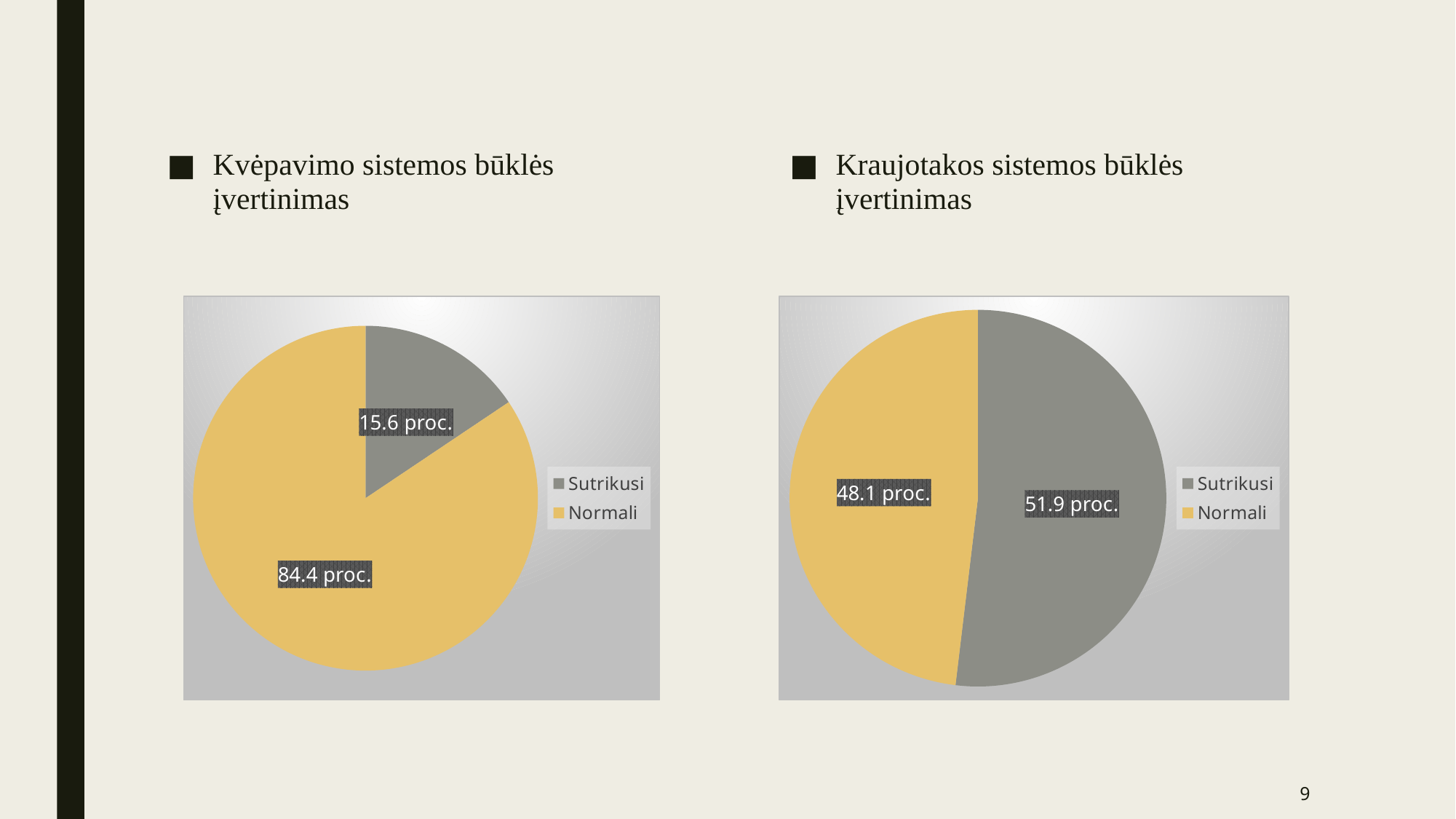
What kind of chart is the left chart (Kvėpavimo sistemos būklės įvertinimas)? Pie chart In the right chart (Kraujotakos sistemos būklės įvertinimas), which category has the smallest share? Normali In the right chart (Kraujotakos sistemos būklės įvertinimas), what is the difference between the Sutrikusi and Normali values? 3.8 proc. In the right chart (Kraujotakos sistemos būklės įvertinimas), what is the value for Sutrikusi? 51.9 proc. In the right chart (Kraujotakos sistemos būklės įvertinimas), what is the value for Normali? 48.1 proc. In the left chart (Kvėpavimo sistemos būklės įvertinimas), which category has the largest share? Normali In the right chart (Kraujotakos sistemos būklės įvertinimas), which is larger, Sutrikusi or Normali? Sutrikusi In the left chart (Kvėpavimo sistemos būklės įvertinimas), what colour is the Normali slice? Yellow In the left chart (Kvėpavimo sistemos būklės įvertinimas), what is the value for Normali? 84.4 proc. In the left chart (Kvėpavimo sistemos būklės įvertinimas), what is the difference between the Normali and Sutrikusi values? 68.8 proc. How many categories does the legend of the right chart (Kraujotakos sistemos būklės įvertinimas) list? 2 In the left chart (Kvėpavimo sistemos būklės įvertinimas), what is the value for Sutrikusi? 15.6 proc.